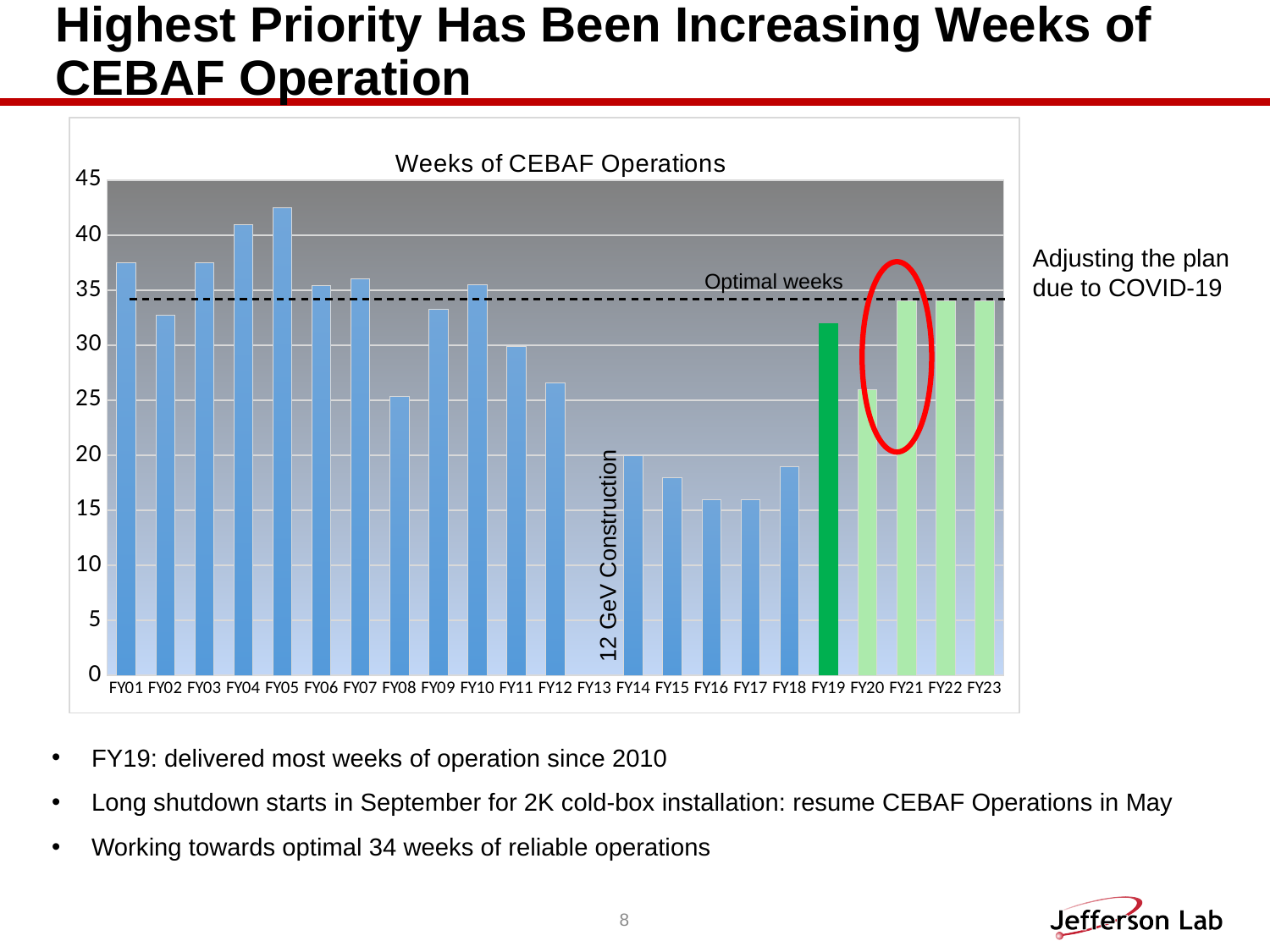
Is the value for FY08 greater or less than 30? less Is the value for FY19 greater or less than 30? greater What is the title of the chart? Weeks of CEBAF Operations Which has more weeks of operation, FY04 or FY02? FY04 How many fiscal years are labelled on the x axis of the chart? 23 Do the values rise or fall from FY14 to FY16? fall Which has more weeks of operation, FY10 or FY12? FY10 What text is written in place of a bar for FY13? 12 GeV Construction Which fiscal year has the highest number of weeks of CEBAF operations? FY05 Is the value for FY01 greater or less than 35? greater What kind of chart is shown on the slide? bar chart